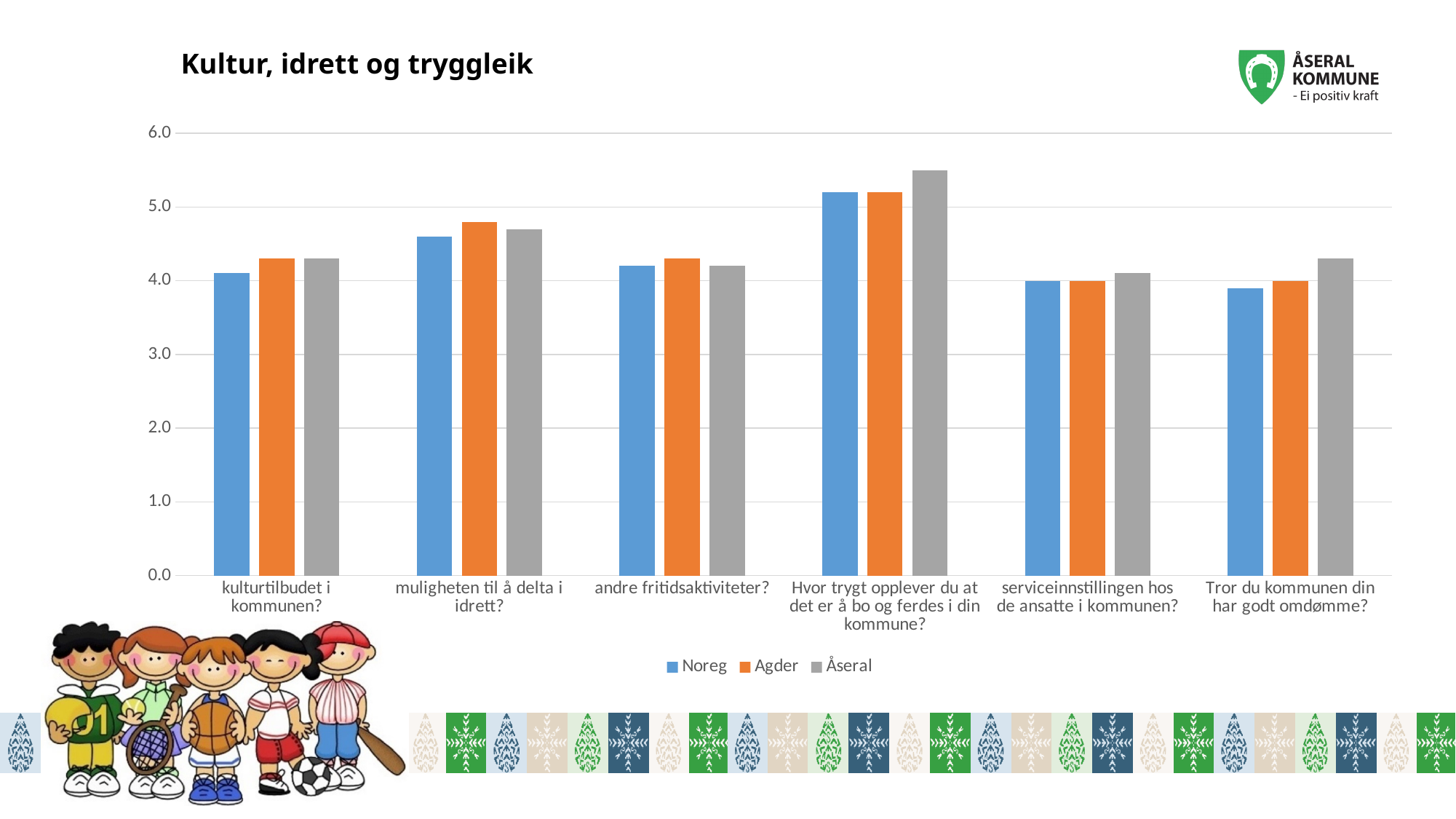
Which is larger for 'kulturtilbudet i kommunen?': the Noreg value or the Agder value? Agder How many series does the legend list? 3 Which series has the highest value for 'Tror du kommunen din har godt omdømme?'? Åseral Which colour represents the Agder series in the legend? orange For which category does Åseral have its highest value? Hvor trygt opplever du at det er å bo og ferdes i din kommune? How many question categories are shown along the x axis? 6 What is the title of the chart? Kultur, idrett og tryggleik What kind of chart is shown on the slide? bar chart Which is larger for 'Tror du kommunen din har godt omdømme?': the Noreg value or the Åseral value? Åseral Is the Agder value for 'muligheten til å delta i idrett?' greater or less than 5.0? less Which series has the highest value for 'Hvor trygt opplever du at det er å bo og ferdes i din kommune?'? Åseral Is the Åseral value for 'Hvor trygt opplever du at det er å bo og ferdes i din kommune?' greater or less than 5.0? greater